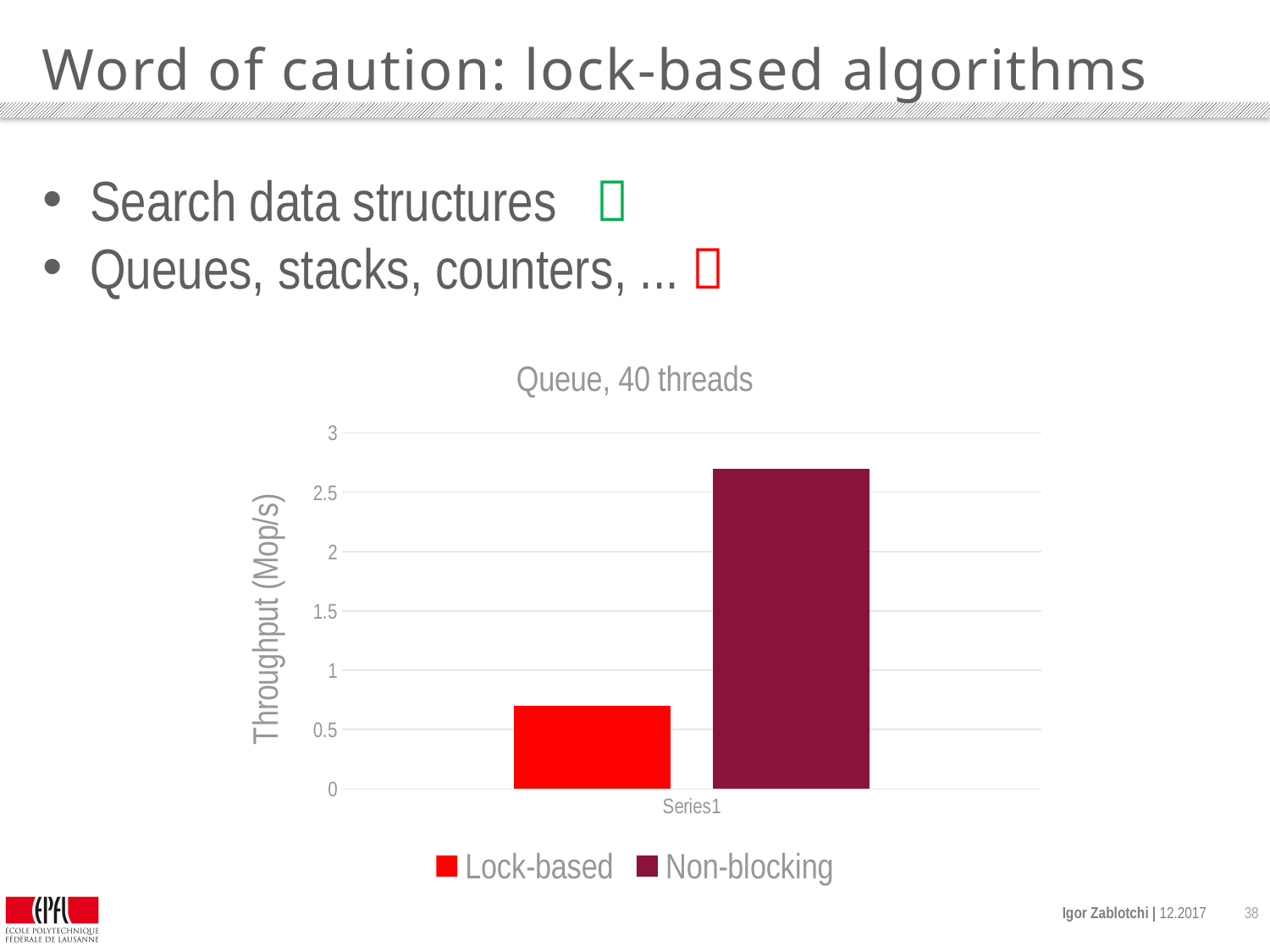
Which series has the lowest throughput in the chart? Lock-based How many series does the chart legend list? 2 Is the throughput for Lock-based greater or less than 0.5? greater What is the label on the vertical axis of the chart? Throughput (Mop/s) Is the throughput for Non-blocking greater or less than 2? greater What kind of chart is shown on the slide? bar chart Which series has the highest throughput in the chart? Non-blocking Is the throughput for Lock-based greater or less than 1? less What is the title of the chart? Queue, 40 threads How many categories are shown on the x axis of the chart? 1 Which series has the higher throughput, Lock-based or Non-blocking? Non-blocking